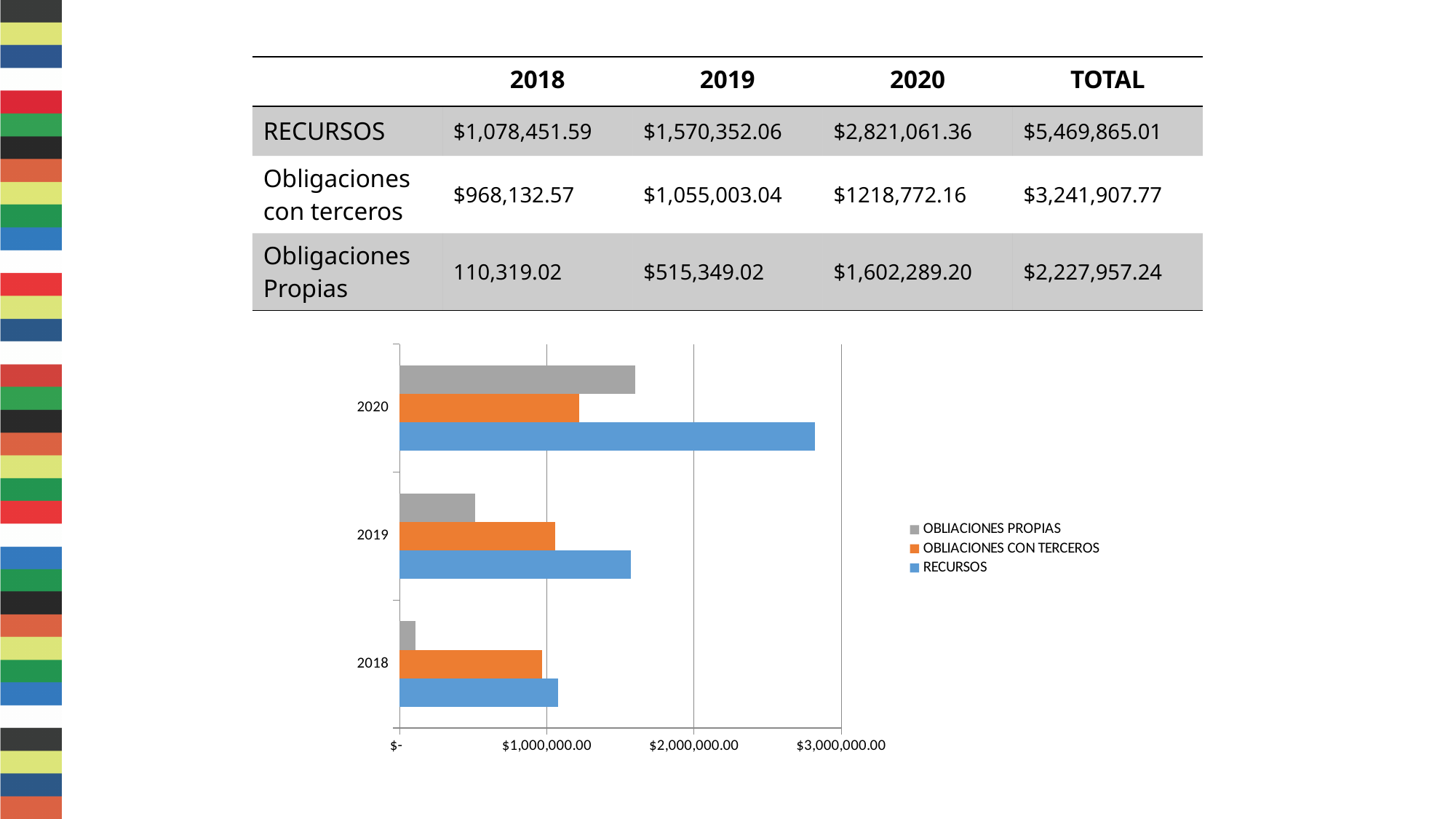
How many series does the chart legend list? 3 According to the table on the slide, what is the RECURSOS value for 2020? $2,821,061.36 What kind of chart is shown on the slide? bar chart In 2020, which is larger: RECURSOS or OBLIACIONES CON TERCEROS? RECURSOS Is the OBLIACIONES PROPIAS bar for 2018 greater or less than $1,000,000.00? less What colour represents RECURSOS in the chart legend? blue Which year has the lowest OBLIACIONES PROPIAS bar? 2018 Is the OBLIACIONES PROPIAS bar for 2019 greater or less than $1,000,000.00? less Do the RECURSOS values rise or fall from 2018 to 2020? rise Is the RECURSOS bar for 2020 greater or less than $2,000,000.00? greater Which year has the highest RECURSOS bar? 2020 How many years are shown on the chart's vertical axis? 3